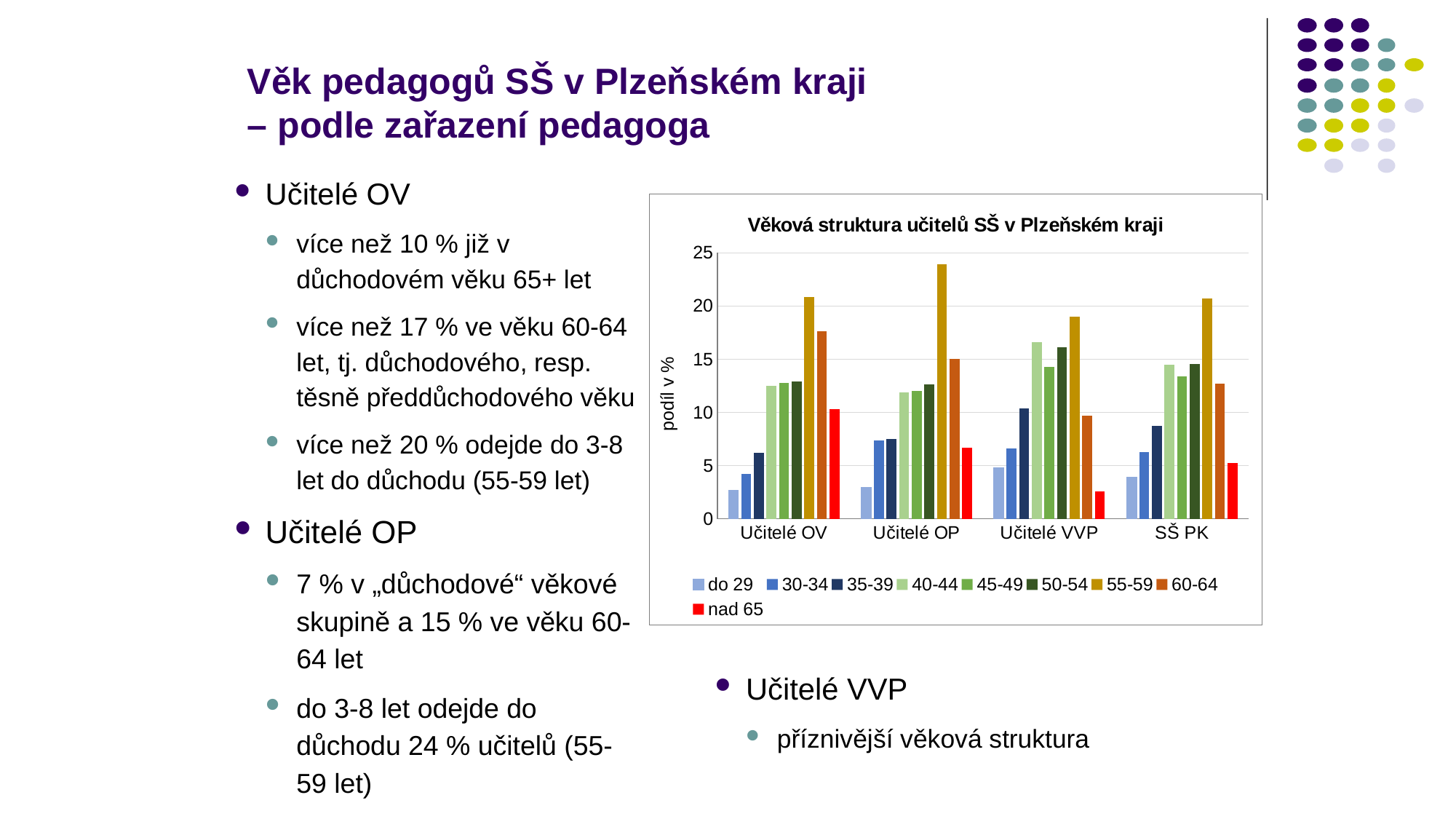
Which is larger: the 40-44 value for Učitelé VVP or for Učitelé OV? Učitelé VVP What is the label of the y axis of the chart? podíl v % Which category has the highest value for the 55-59 series? Učitelé OP Is the value for nad 65 in Učitelé OV greater or less than 5? greater How many categories are shown on the x axis of the chart? 4 Which age group has the highest value in the SŠ PK category? 55-59 Is the value for 55-59 in Učitelé OP greater or less than 20? greater How many series does the chart legend list? 9 What kind of chart is shown on the slide? bar chart Which is larger: the 60-64 value for Učitelé OV or for Učitelé OP? Učitelé OV Is the value for do 29 in Učitelé VVP greater or less than 10? less Which category has the lowest value for the nad 65 series? Učitelé VVP